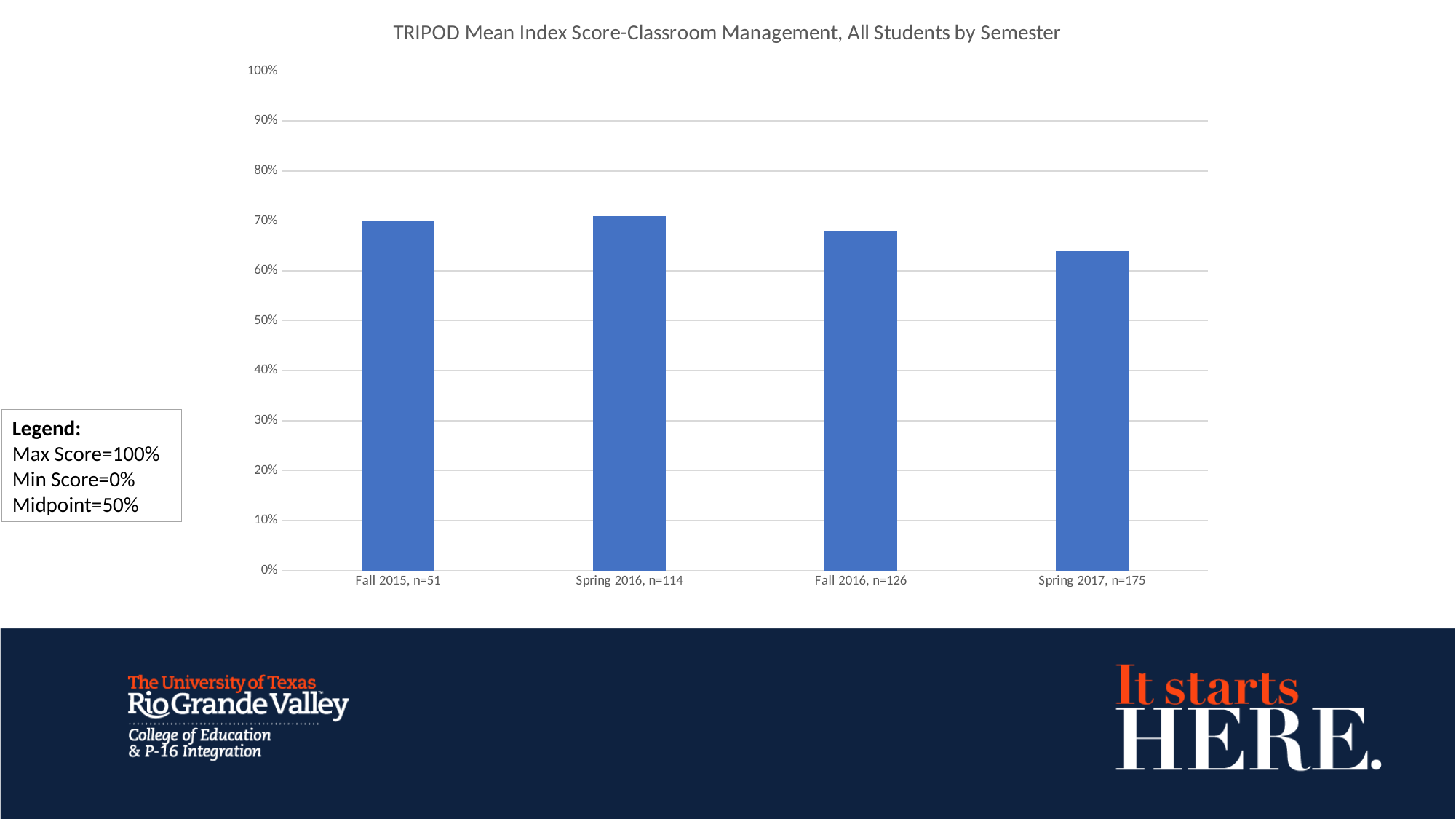
From Spring 2016 to Spring 2017, do the values rise or fall? fall Is the value for Spring 2017, n=175 greater or less than 70%? less Which is larger, the value for Fall 2016, n=126 or the value for Spring 2017, n=175? Fall 2016, n=126 Which is larger, the value for Fall 2015, n=51 or the value for Spring 2017, n=175? Fall 2015, n=51 According to the legend box on the slide, what is the midpoint score? 50% Is the value for Spring 2017, n=175 greater or less than 60%? greater Is the value for Fall 2016, n=126 greater or less than 70%? less How many semesters (bars) are shown in the chart? 4 What is the title of the chart? TRIPOD Mean Index Score-Classroom Management, All Students by Semester What kind of chart is shown on the slide? bar chart Which semester has the lowest mean index score? Spring 2017, n=175